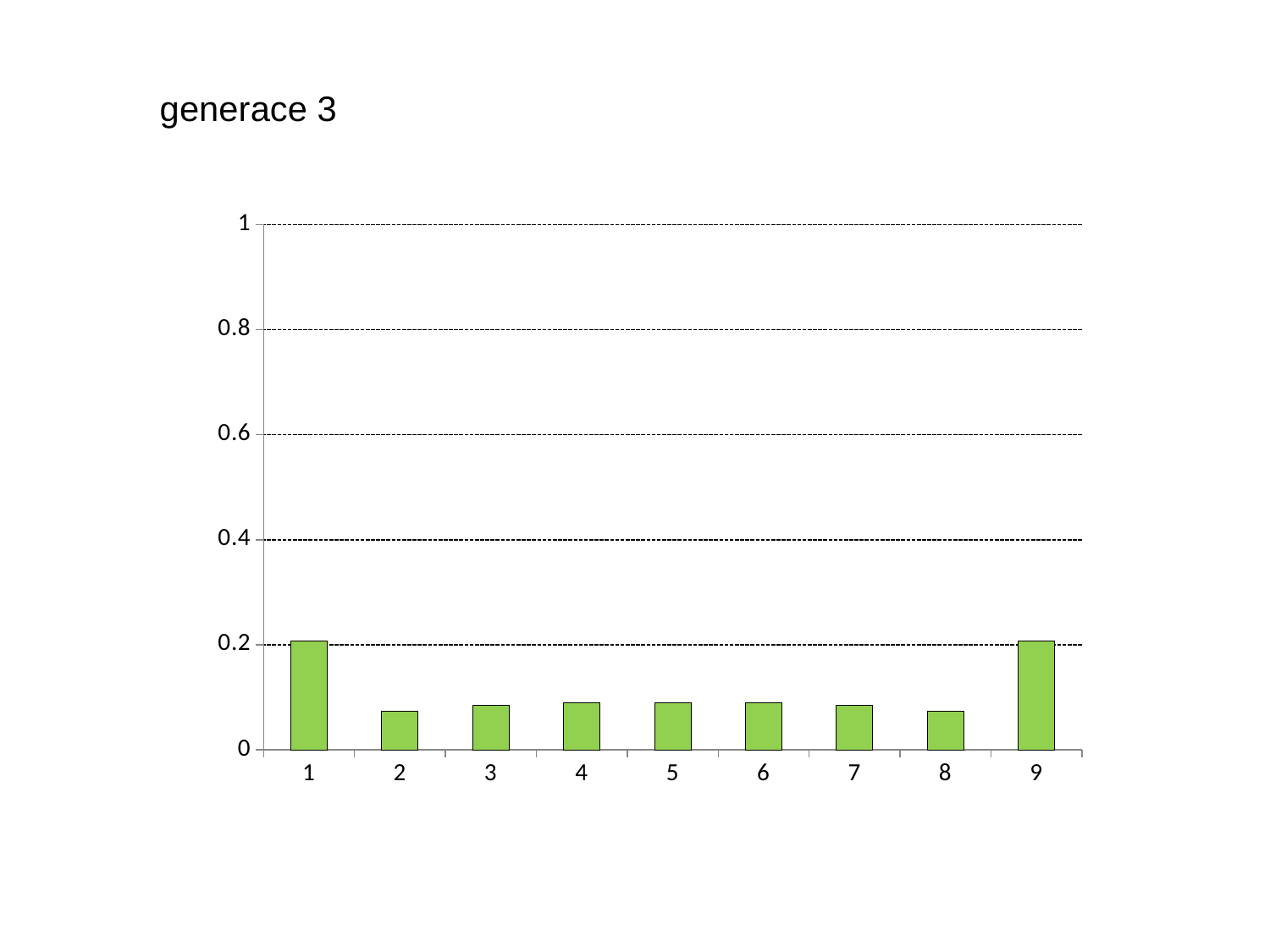
Which has the larger value, category 9 or category 5? category 9 Is the value for category 2 greater or less than 0.2? less Is the value for category 1 greater or less than 0.4? less How many bars (categories) does the chart show? 9 What is the highest value shown on the y axis? 1 Is the value for category 5 greater or less than 0.2? less Which has the larger value, category 1 or category 2? category 1 What colour are the bars in the chart? green Which has the larger value, category 8 or category 9? category 9 What kind of chart is shown on the slide? bar chart